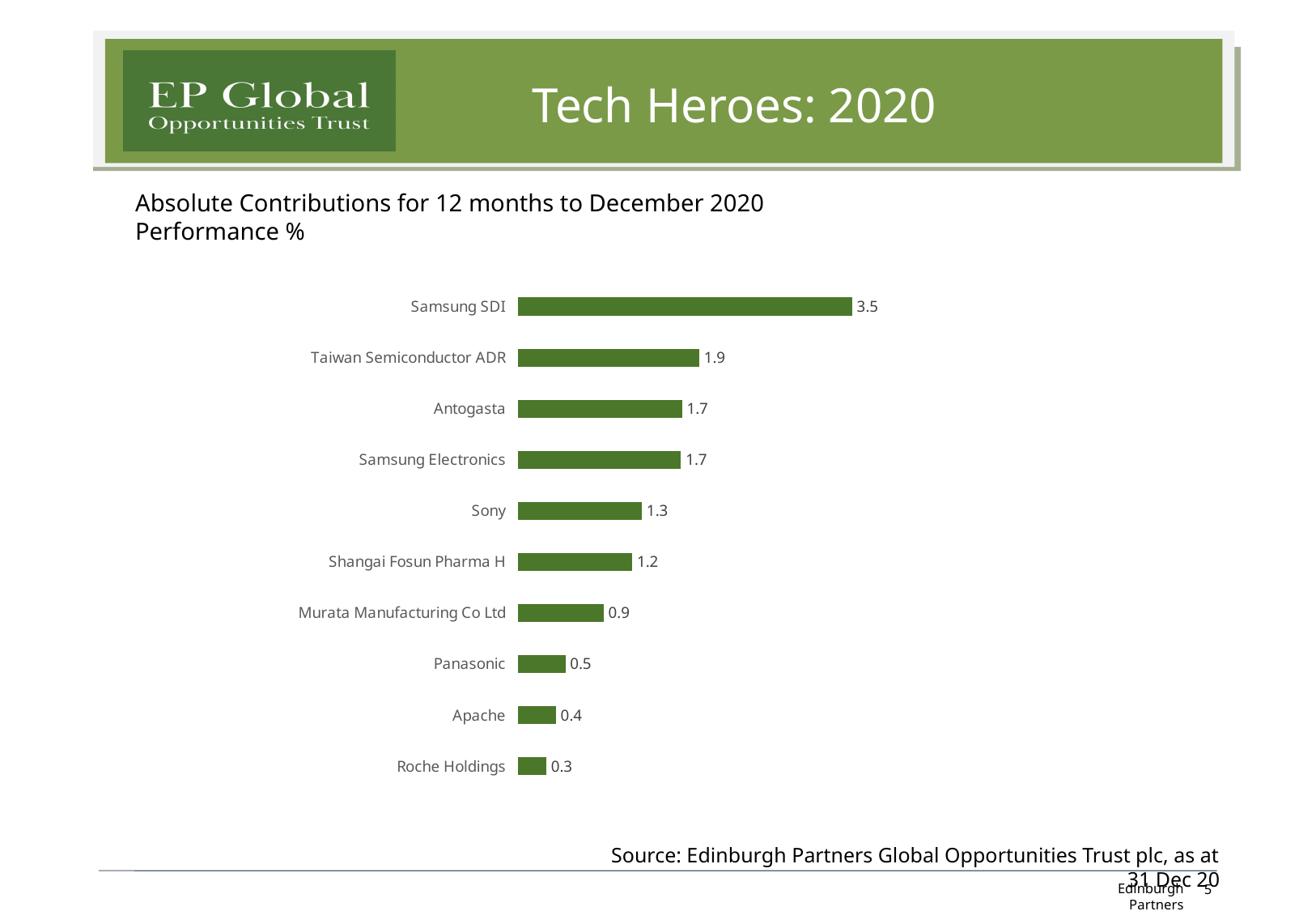
What is the difference between the values for Sony and Panasonic? 0.8 What is the title of the slide? Tech Heroes: 2020 What is the value for Taiwan Semiconductor ADR? 1.9 Which is larger, the value for Sony or the value for Apache? Sony What is the value for Samsung SDI? 3.5 Which category has the lowest value? Roche Holdings How many categories are shown in the chart? 10 What kind of chart is shown on the slide? Bar chart What is the value for Shangai Fosun Pharma H? 1.2 Which category has the highest value? Samsung SDI What is the difference between the values for Samsung SDI and Taiwan Semiconductor ADR? 1.6 What is the value for Murata Manufacturing Co Ltd? 0.9